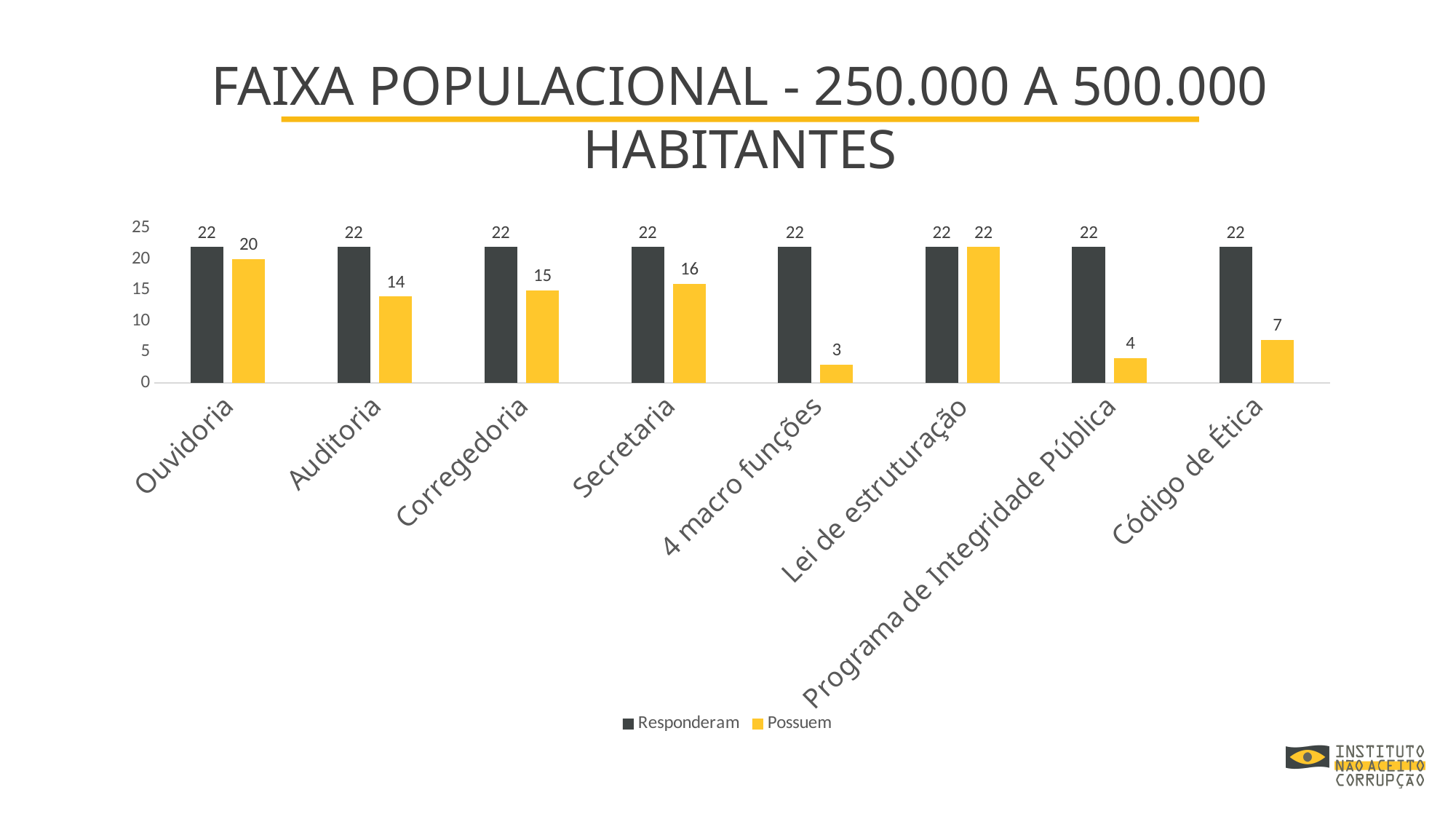
What is the 'Possuem' value for Auditoria? 14 Which series is shown in yellow? Possuem Which category has the highest 'Possuem' value? Lei de estruturação What is the 'Possuem' value for Ouvidoria? 20 Which is larger, the 'Possuem' value for Secretaria or for Código de Ética? Secretaria What is the difference between the 'Responderam' and 'Possuem' values for Corregedoria? 7 What kind of chart is shown on the slide? Bar chart What is the 'Responderam' value for Secretaria? 22 Which category has the lowest 'Possuem' value? 4 macro funções How many categories are shown on the x axis? 8 What is the 'Possuem' value for Programa de Integridade Pública? 4 How many series does the legend list? 2